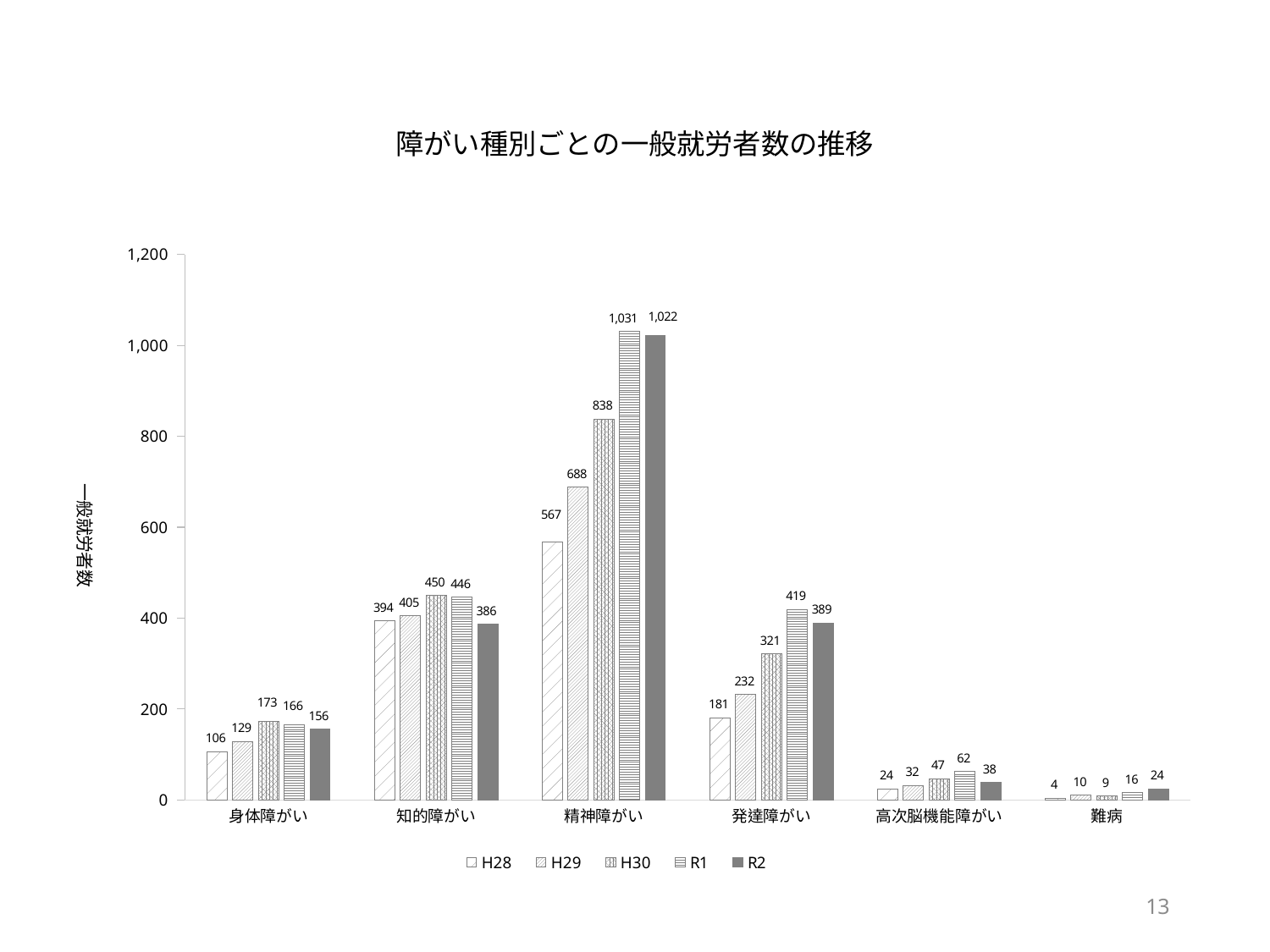
Which category has the highest value in the R2 series? 精神障がい Which category has the lowest value in the H28 series? 難病 How many series does the legend list? 5 What is the value for 精神障がい in the R1 series? 1,031 Do the values for 発達障がい rise or fall from H28 to R1? Rise What is the value for 高次脳機能障がい in the R2 series? 38 What is the title of the chart? 障がい種別ごとの一般就労者数の推移 What is the difference between the R1 and R2 values for 発達障がい? 30 What is the value for 身体障がい in the H28 series? 106 How many categories are shown on the x axis? 6 Which is larger for 知的障がい: the H30 value or the R2 value? H30 What kind of chart is shown on the slide? Bar chart